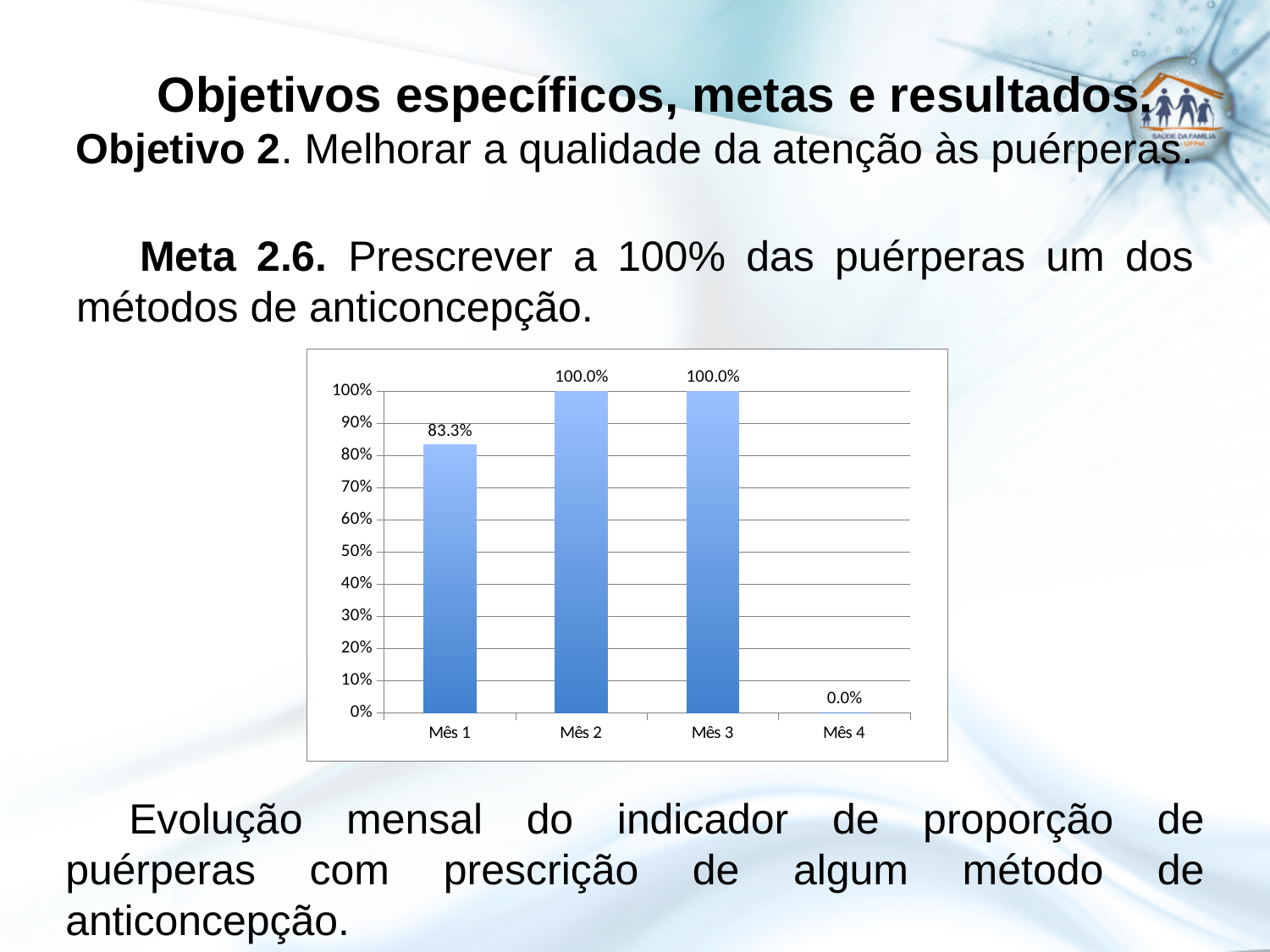
What is the difference between the values for Mês 2 and Mês 1? 16.7% Which is larger, the value for Mês 1 or the value for Mês 3? Mês 3 What kind of chart is shown on the slide? bar chart Is the value for Mês 1 greater or less than 80%? greater How many categories are shown on the x axis? 4 Which category has the lowest value? Mês 4 Do the values rise or fall from Mês 3 to Mês 4? fall What is the value for Mês 4? 0.0% What is the highest value shown on the y axis? 100% How many bars reach 100.0%? 2 What is the value for Mês 2? 100.0% What is the value for Mês 1? 83.3%